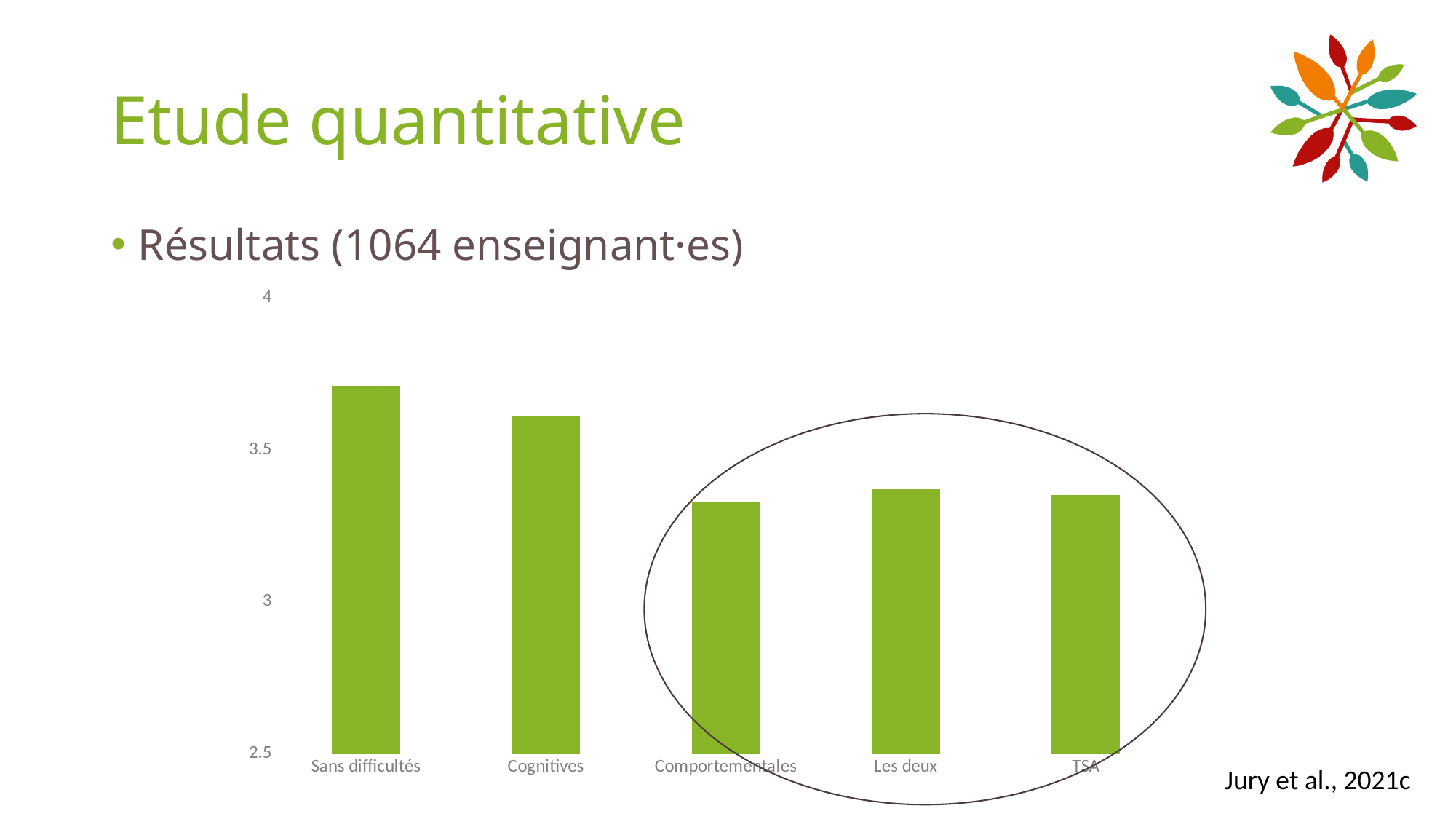
How many bars are enclosed by the drawn ellipse on the chart? 3 Is the value for Comportementales greater or less than 3.5? less Do the values fall or rise from Sans difficultés to Comportementales along the x axis? fall Is the value for Sans difficultés greater or less than 3.5? greater Is the value for TSA greater or less than 3? greater Which category has the highest bar in the chart? Sans difficultés How many categories are shown on the x axis of the chart? 5 What kind of chart is shown on the slide? bar chart Which is larger, the value for Sans difficultés or the value for Cognitives? Sans difficultés Which is larger, the value for Cognitives or the value for Les deux? Cognitives Which is larger, the value for Sans difficultés or the value for TSA? Sans difficultés